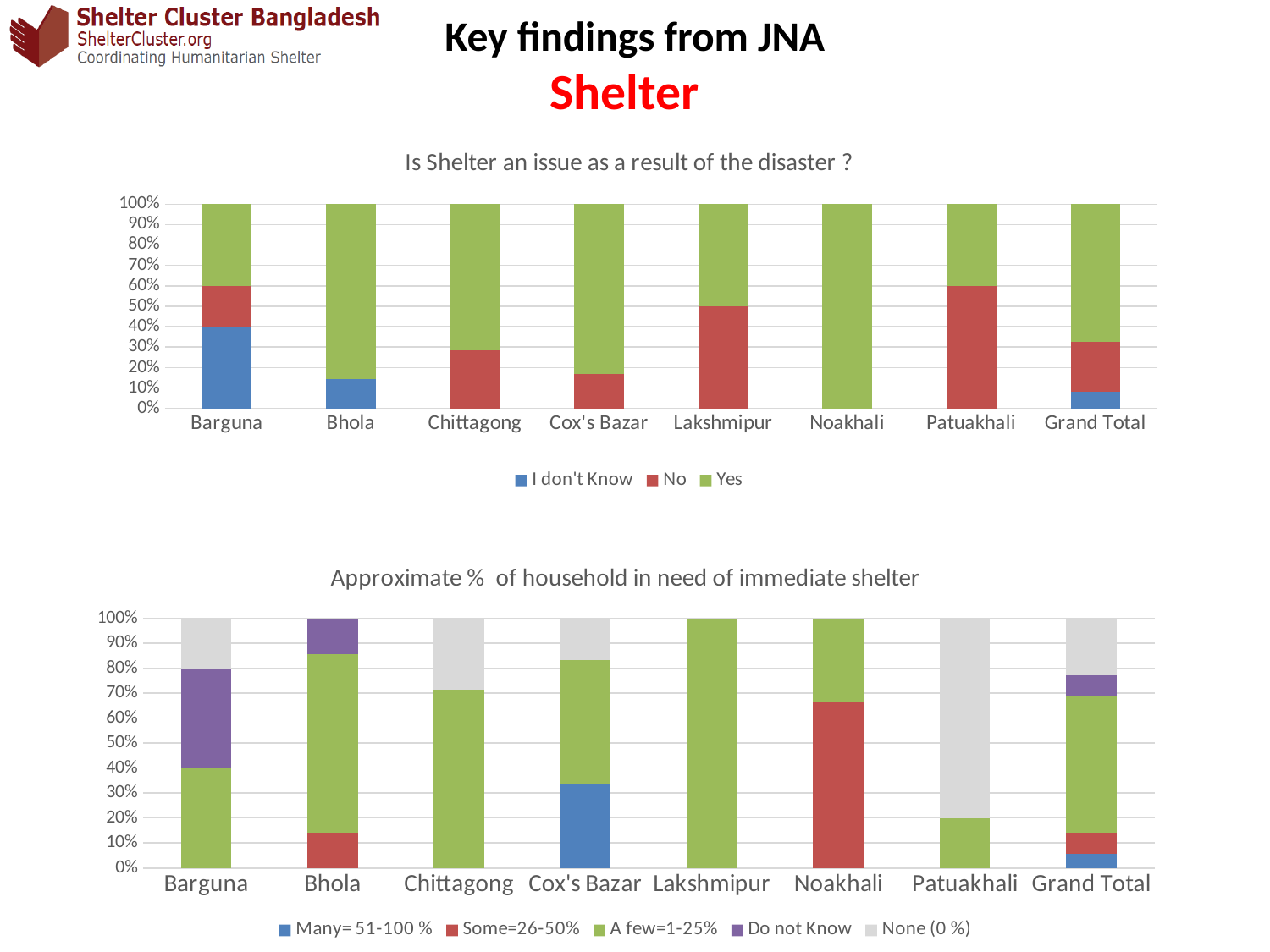
What kind of chart is the top chart, 'Is Shelter an issue as a result of the disaster ?'? Stacked bar chart In the top chart, 'Is Shelter an issue as a result of the disaster ?', is the 'I don't Know' share for Barguna greater or less than 30%? greater In the top chart, 'Is Shelter an issue as a result of the disaster ?', how many series does the legend list? 3 In the top chart, 'Is Shelter an issue as a result of the disaster ?', how many categories are shown on the x axis? 8 In the bottom chart, 'Approximate % of household in need of immediate shelter', which category has the largest 'A few=1-25%' share? Lakshmipur In the bottom chart, 'Approximate % of household in need of immediate shelter', how many series does the legend list? 5 In the bottom chart, 'Approximate % of household in need of immediate shelter', is the 'None (0 %)' share for Patuakhali greater or less than 70%? greater In the top chart, 'Is Shelter an issue as a result of the disaster ?', is the 'No' share larger for Lakshmipur or for Cox's Bazar? Lakshmipur In the top chart, 'Is Shelter an issue as a result of the disaster ?', is the 'No' share for Patuakhali greater or less than 50%? greater In the bottom chart, 'Approximate % of household in need of immediate shelter', how many categories are shown on the x axis? 8 In the top chart, 'Is Shelter an issue as a result of the disaster ?', which category has the largest 'Yes' share? Noakhali